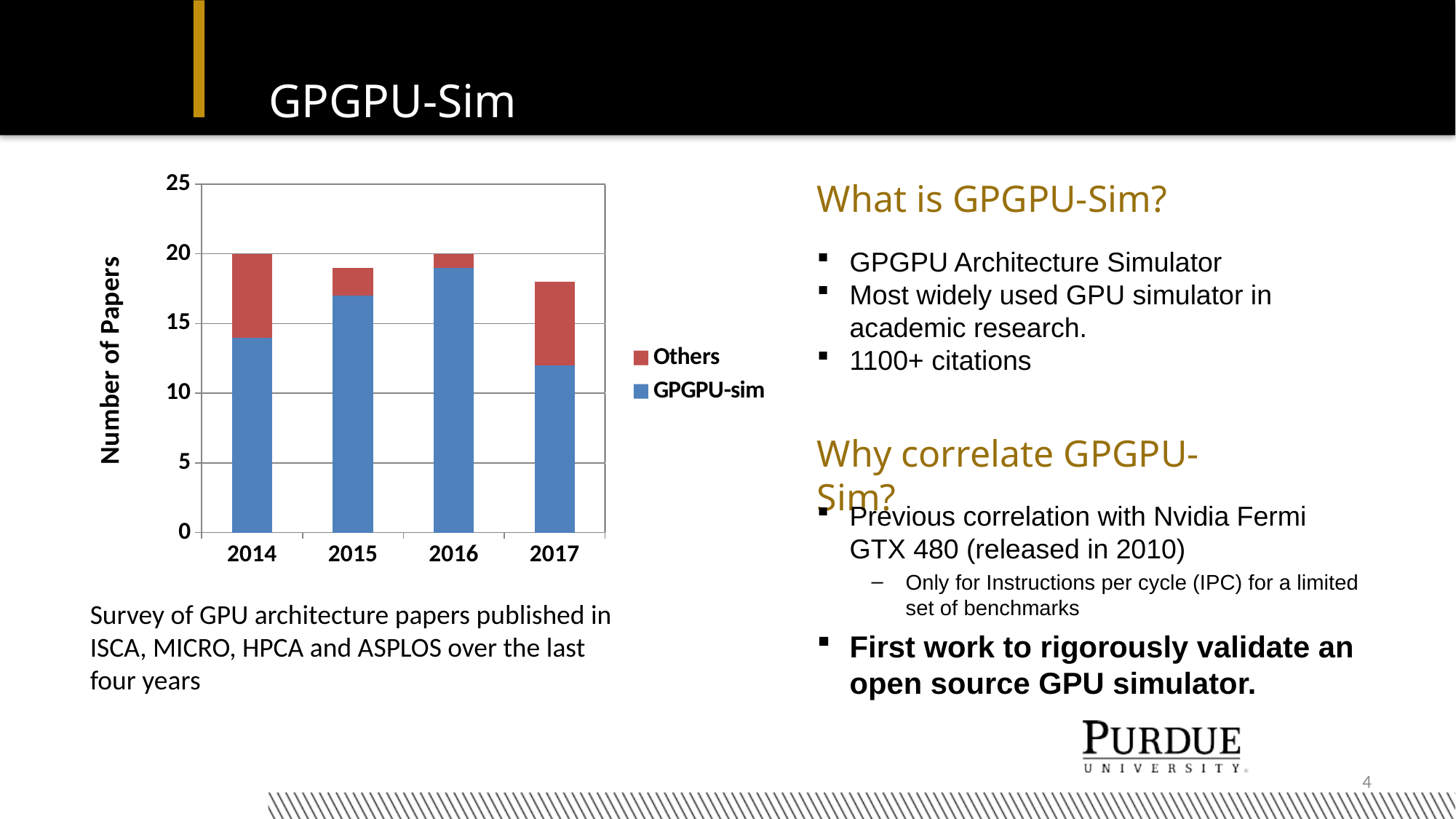
What is the label on the y axis of the chart? Number of Papers What is the total height of the stacked bar for 2016? 20 How many years are shown on the x axis of the chart? 4 Is the GPGPU-sim value for 2014 greater or less than 15? less Which year has the highest GPGPU-sim value? 2016 How many series does the chart legend list? 2 What is the total height of the stacked bar for 2014? 20 Which year has the lowest GPGPU-sim value? 2017 Which year has the smallest Others segment? 2016 Which is larger, the GPGPU-sim value for 2015 or for 2017? 2015 Is the GPGPU-sim value for 2015 greater or less than 15? greater What kind of chart is shown on the slide? bar chart